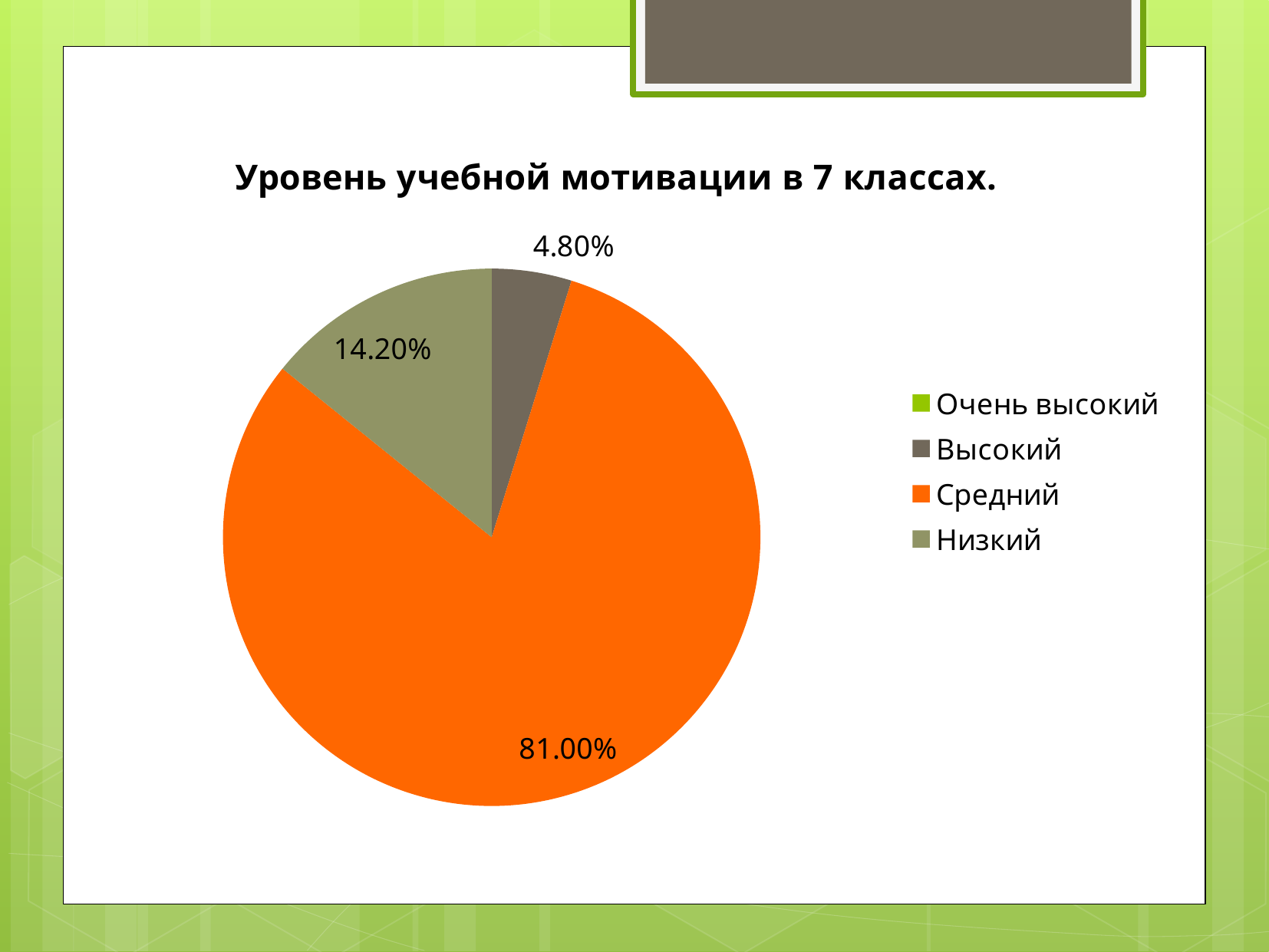
Which category has the largest slice of the pie? Средний What is the difference between the shares for Средний and Низкий? 66.80% Which of the labelled slices is the smallest? Высокий What kind of chart is shown on the slide? Pie chart What is the title of the chart? Уровень учебной мотивации в 7 классах. What share of the pie is labelled for Средний? 81.00% Which colour represents Средний in the chart? Orange Which is larger, the share for Низкий or the share for Высокий? Низкий How many entries does the legend list? 4 What share of the pie is labelled for Высокий? 4.80% What share of the pie is labelled for Низкий? 14.20% What is the difference between the shares for Низкий and Высокий? 9.40%